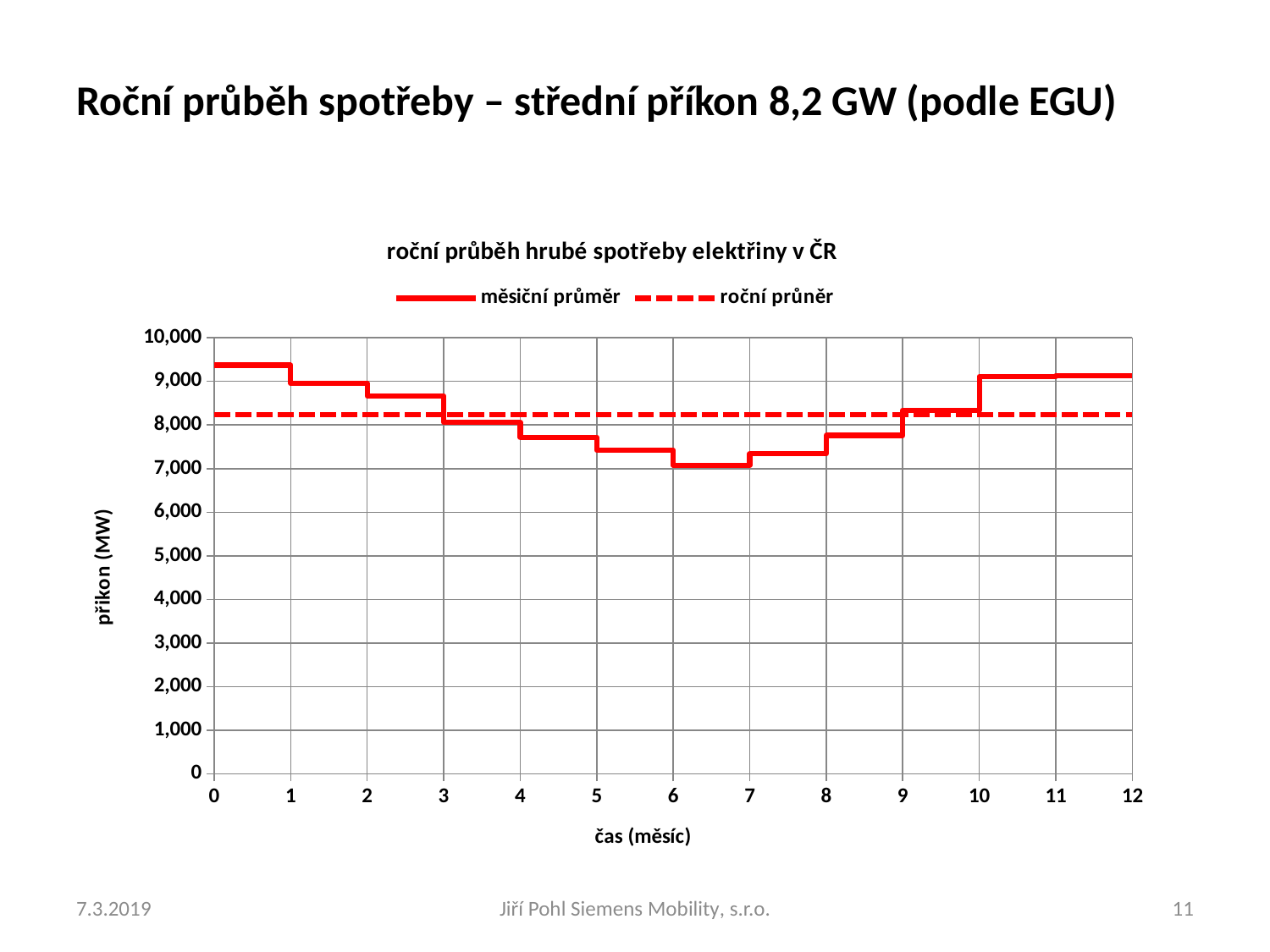
In which month interval is the monthly average (měsiční průměr) lowest? month 6 to 7 How many series does the legend list? 2 Is the monthly average (měsiční průměr) value between month 0 and month 1 greater or less than 9,000? greater In which month interval is the monthly average (měsiční průměr) highest? month 0 to 1 Is the monthly average (měsiční průměr) value between month 4 and month 5 greater or less than 8,000? less What is the title of the chart? roční průběh hrubé spotřeby elektřiny v ČR Does the monthly average (měsiční průměr) rise or fall from month 0 to month 6? fall Which is larger: the monthly average between month 0 and 1, or between month 6 and 7? month 0 to 1 What kind of chart is shown on the slide? line chart What are the two series named in the legend? měsiční průměr and roční průněr Is the monthly average (měsiční průměr) value between month 6 and month 7 greater or less than 8,000? less